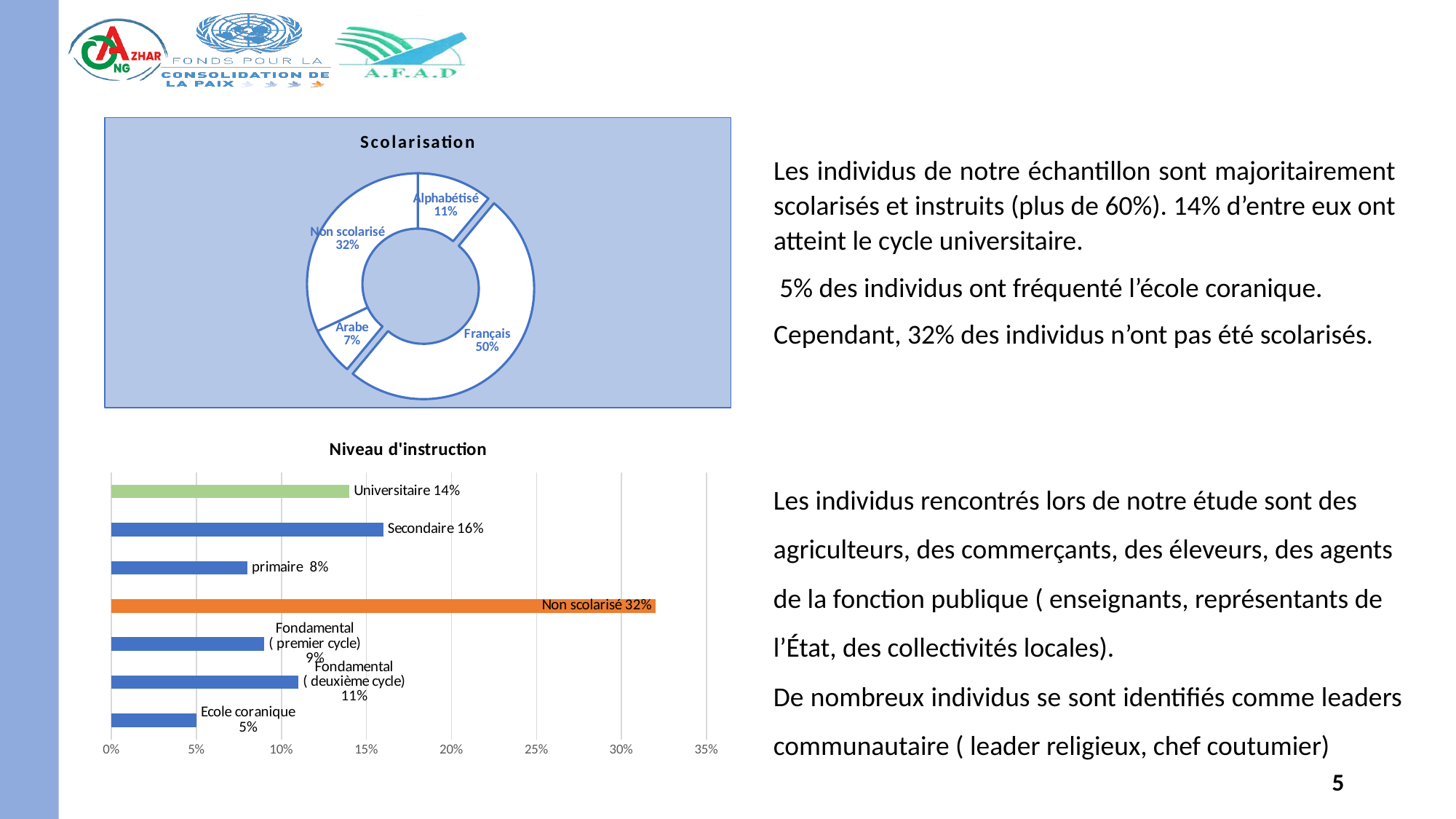
In the 'Scolarisation' chart, what share is labelled for Français? 50% In the 'Niveau d'instruction' chart, what is the value for Secondaire? 16% What kind of chart is the 'Scolarisation' chart? Doughnut (pie) chart In the 'Scolarisation' chart, which category has the smallest share? Arabe In the 'Niveau d'instruction' chart, which is larger: Fondamental (premier cycle) or Fondamental (deuxième cycle)? Fondamental (deuxième cycle) In the 'Niveau d'instruction' chart, what is the difference between Non scolarisé and Universitaire? 18% In the 'Scolarisation' chart, what share is labelled for Arabe? 7% In the 'Scolarisation' chart, which category has the largest share? Français In the 'Niveau d'instruction' chart, which category has the highest value? Non scolarisé What kind of chart is the 'Niveau d'instruction' chart? Bar chart In the 'Niveau d'instruction' chart, what is the value for Ecole coranique? 5% In the 'Scolarisation' chart, how many categories are shown? 4